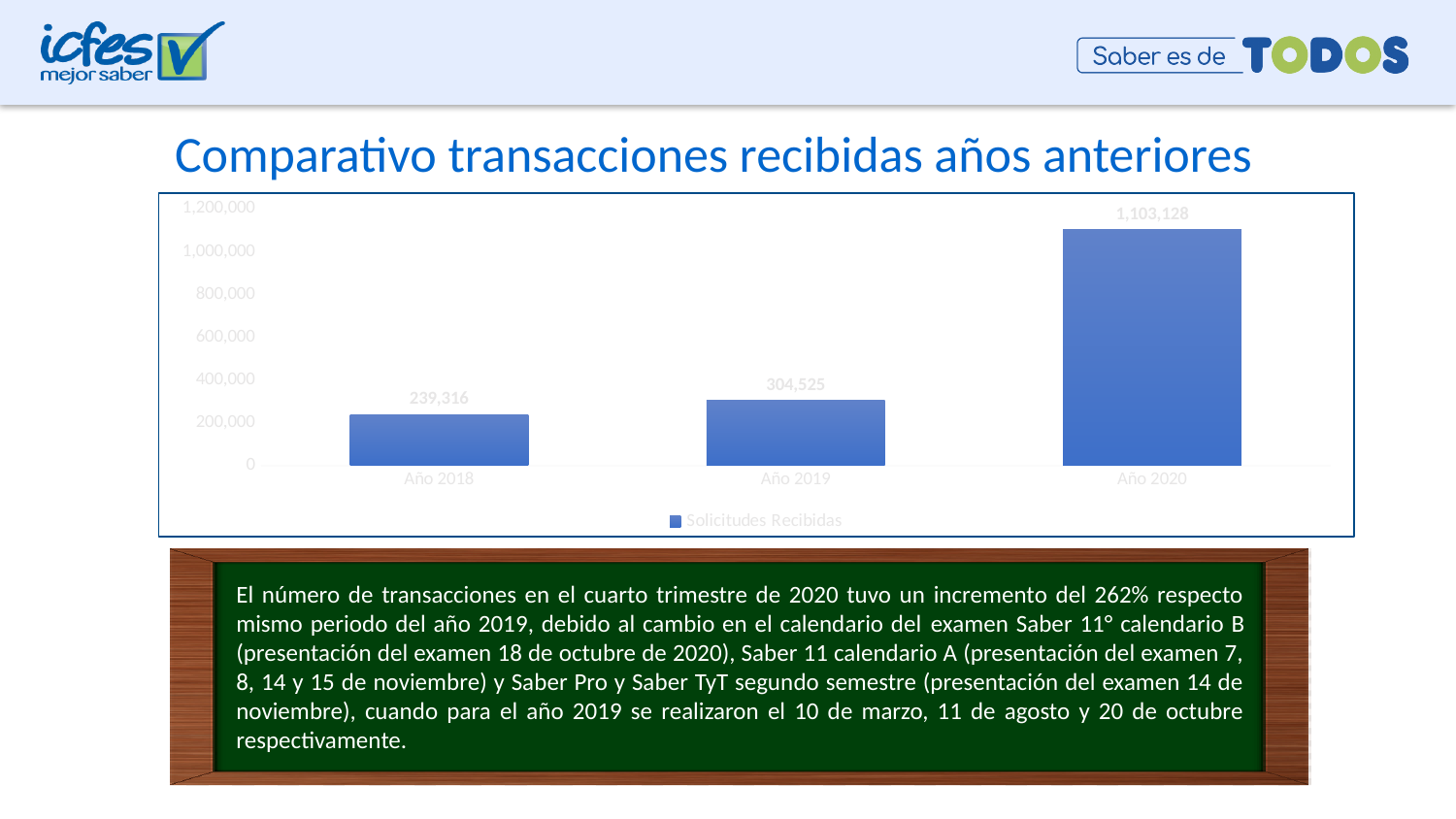
Which is larger, the value for Año 2019 or Año 2018? Año 2019 Which year has the highest value? Año 2020 Is the value for Año 2020 greater or less than 1,000,000? greater Which year has the lowest value? Año 2018 What series name does the legend show? Solicitudes Recibidas What is the value for Año 2020? 1,103,128 What is the difference between the values for Año 2019 and Año 2018? 65,209 What is the difference between the values for Año 2020 and Año 2019? 798,603 What kind of chart is shown on the slide? bar chart What is the value for Año 2019? 304,525 How many categories are shown on the x axis? 3 What is the value for Año 2018? 239,316